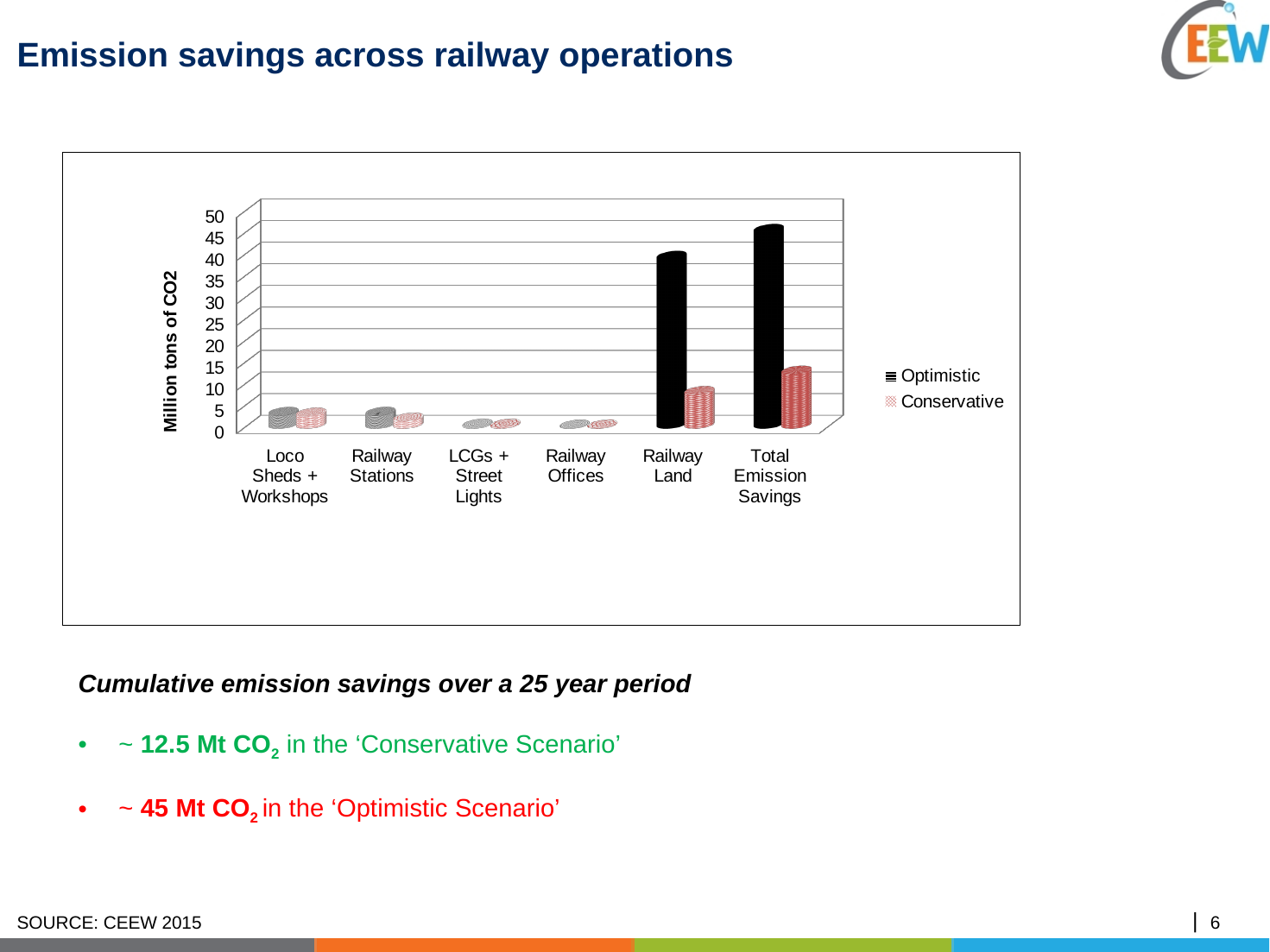
Is the Optimistic value for Total Emission Savings greater or less than 40? greater For Railway Land, which series has the larger value, Optimistic or Conservative? Optimistic What kind of chart is shown on the slide? bar chart Which category has the highest Optimistic value? Total Emission Savings What are the two series named in the chart's legend? Optimistic and Conservative Which category has the highest Conservative value? Total Emission Savings Is the Optimistic value for Railway Land greater or less than 35? greater How many series does the chart's legend list? 2 Is the Conservative value for Railway Land greater or less than 10? less How many categories are shown on the x axis of the chart? 6 What is the label on the vertical axis of the chart? Million tons of CO2